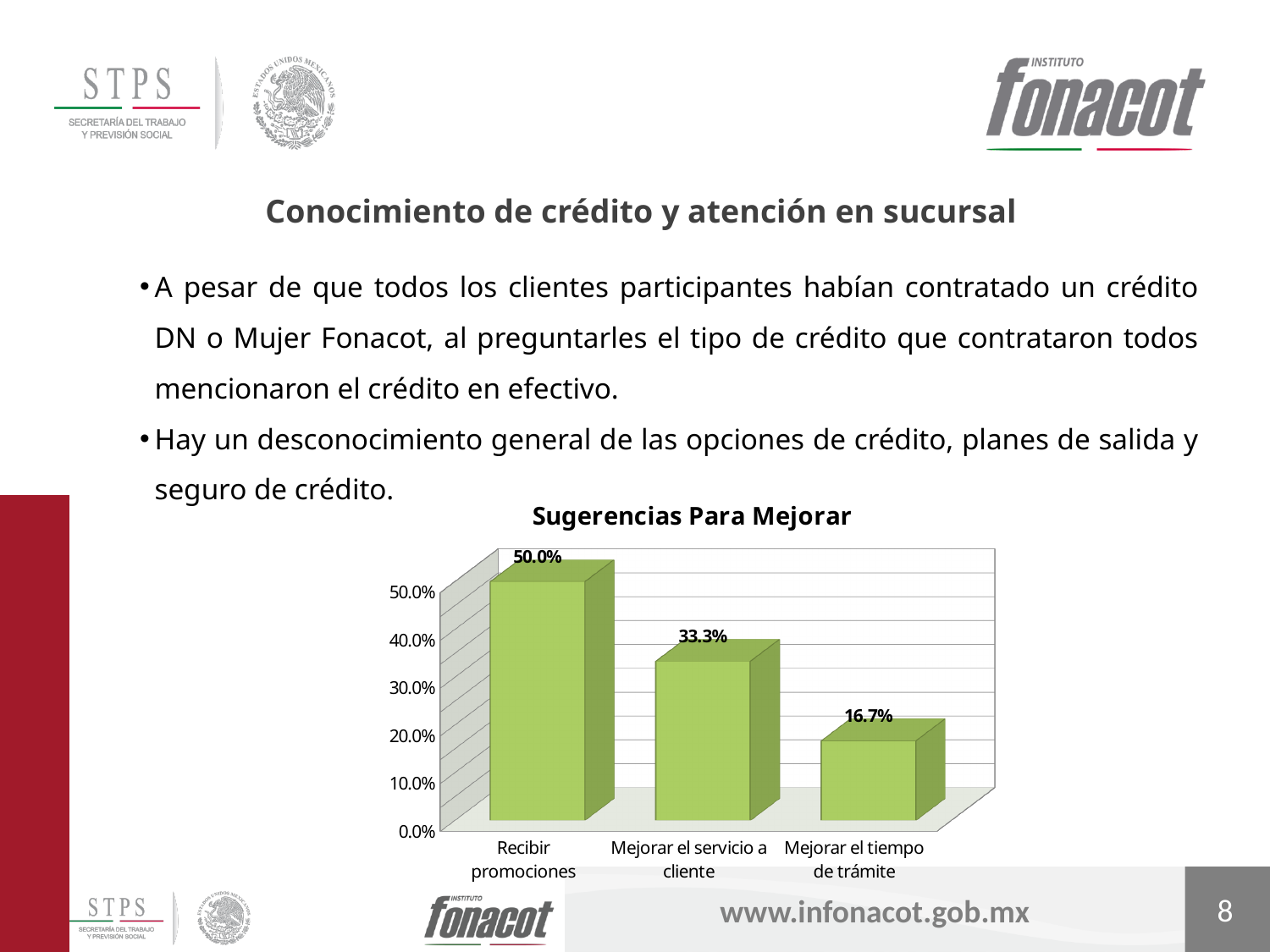
What is the value for "Mejorar el servicio a cliente"? 33.3% How many categories are shown in the chart? 3 What is the value for "Mejorar el tiempo de trámite"? 16.7% Which category has the lowest value? Mejorar el tiempo de trámite Is the value for "Mejorar el servicio a cliente" greater or less than 30.0%? greater Which category has the highest value? Recibir promociones What kind of chart is shown on the slide? bar chart Which is larger, the value for "Recibir promociones" or the value for "Mejorar el tiempo de trámite"? Recibir promociones What is the title of the chart? Sugerencias Para Mejorar What is the difference between the values for "Recibir promociones" and "Mejorar el servicio a cliente"? 16.7% What is the difference between the values for "Mejorar el servicio a cliente" and "Mejorar el tiempo de trámite"? 16.6% What is the value for "Recibir promociones"? 50.0%